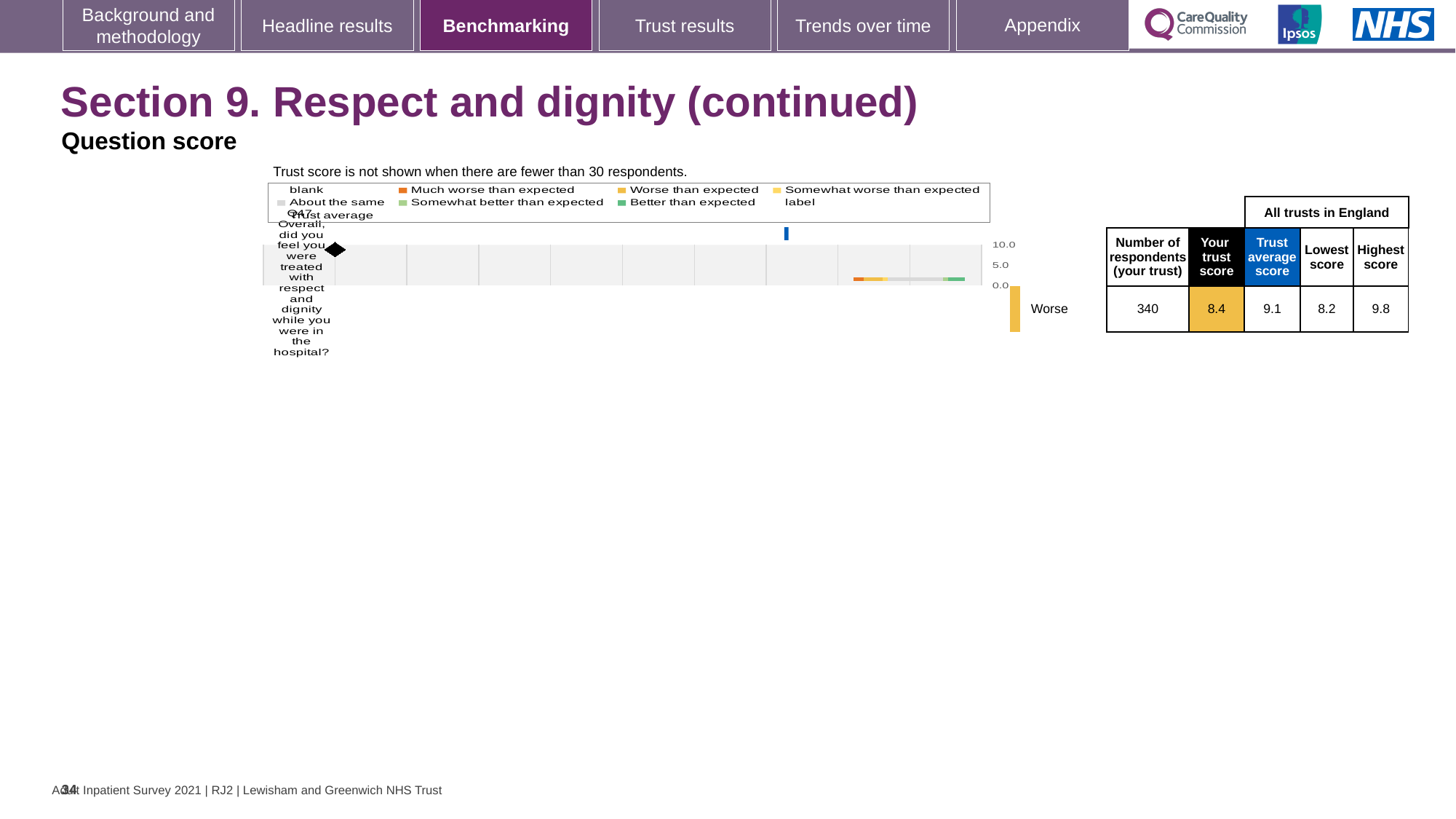
What kind of chart is used to show the Q47 benchmarking result? bar chart What is the trust's score for Q47 (Overall, did you feel you were treated with respect and dignity while you were in the hospital?)? 8.4 What is the highest tick value shown on the chart's axis? 10.0 What is the highest score among all trusts in England for Q47? 9.8 Which benchmarking category is the trust's Q47 result labelled as? Worse What is the lowest score among all trusts in England for Q47? 8.2 What is the difference between the trust average score and the trust's own score for Q47? 0.7 Which is larger for Q47: the trust's own score or the trust average score? Trust average score What is the trust average score for Q47 across all trusts in England? 9.1 What colour is the 'Much worse than expected' legend entry? orange What is the difference between the highest score and the lowest score for Q47? 1.6 How many respondents from the trust answered Q47? 340